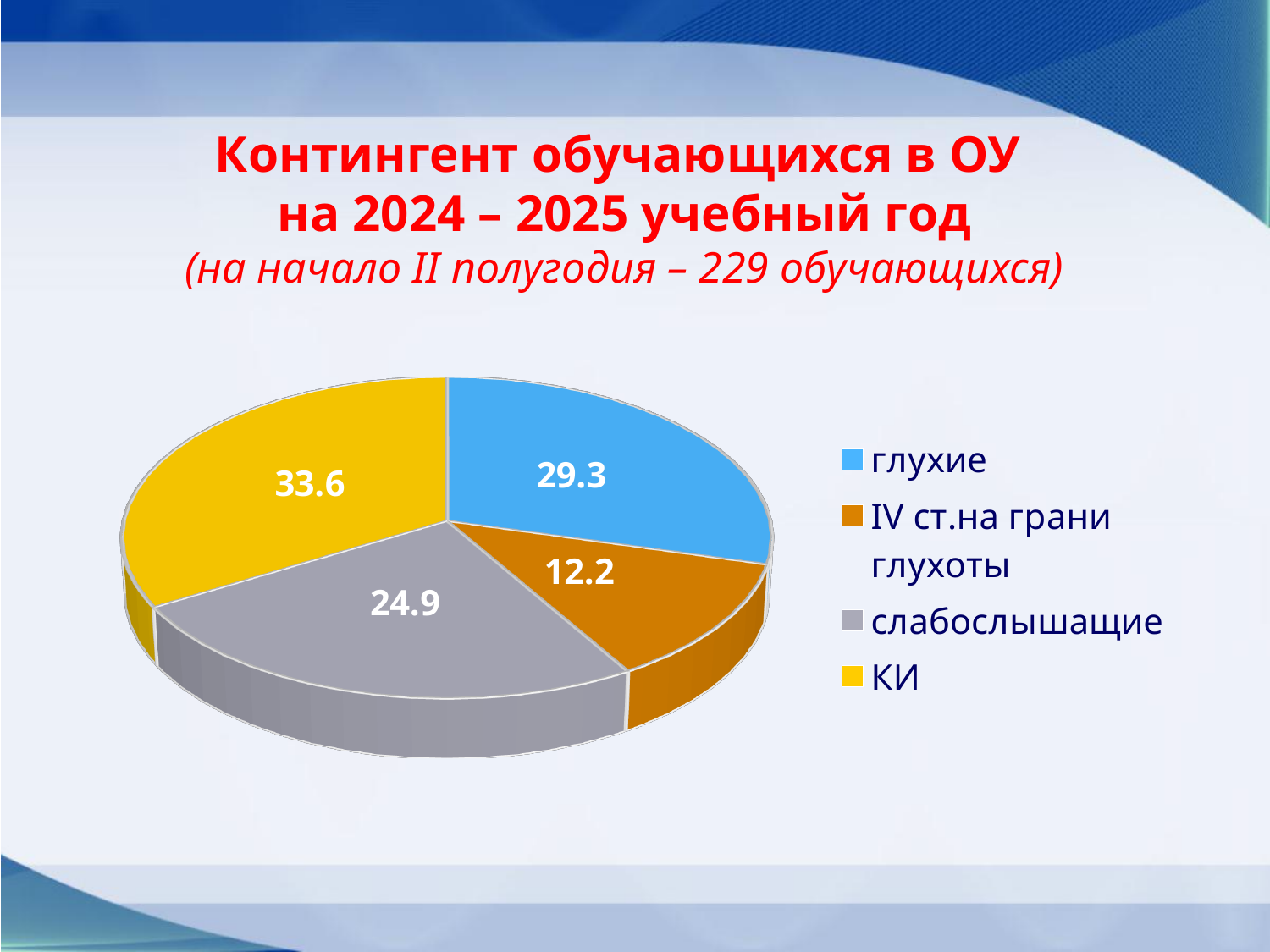
Which category has the smallest slice? IV ст.на грани глухоты How many slices does the pie chart have? 4 How many entries does the legend list? 4 What is the value for слабослышащие? 24.9 Which is larger, the value for слабослышащие or the value for IV ст.на грани глухоты? слабослышащие What colour is the slice for слабослышащие? grey What is the difference between the values for КИ and глухие? 4.3 What kind of chart is shown on the slide? pie chart Which category has the largest slice? КИ What is the value for КИ? 33.6 What is the value for IV ст.на грани глухоты? 12.2 What is the value for глухие? 29.3